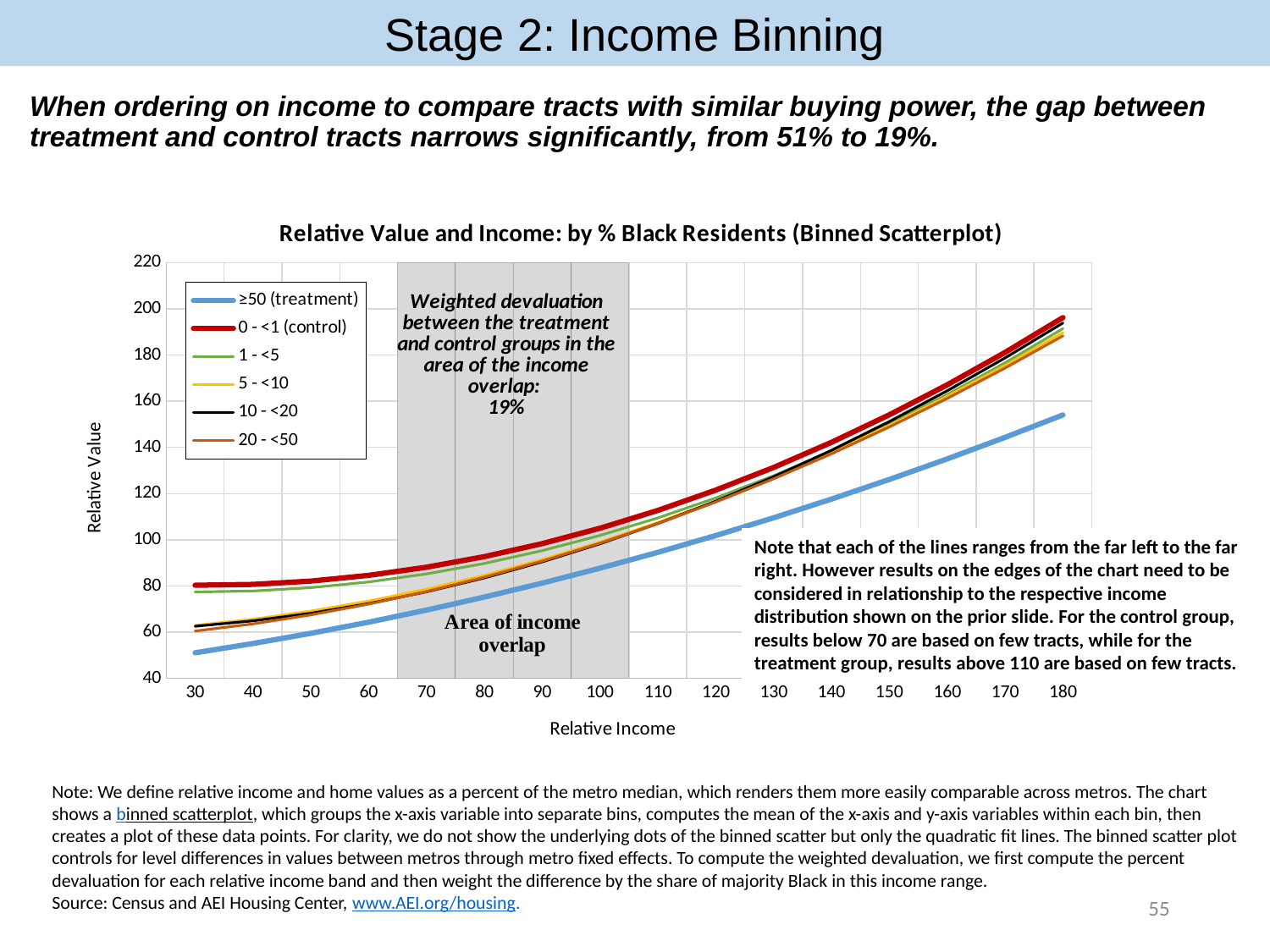
Is the relative value of the ≥50 (treatment) line at a relative income of 150 greater or less than 140? less How many series does the chart's legend list? 6 What weighted devaluation between the treatment and control groups is stated in the area of income overlap? 19% Which series has the lowest relative values across the whole chart? ≥50 (treatment) At a relative income of 100, which is higher: the ≥50 (treatment) line or the 0 - <1 (control) line? 0 - <1 (control) Is the relative value of the 0 - <1 (control) line at a relative income of 180 greater or less than 180? greater What is the title of the chart? Relative Value and Income: by % Black Residents (Binned Scatterplot) Do the values of the ≥50 (treatment) line rise or fall as relative income increases along the x axis? Rise Is the relative value of the 0 - <1 (control) line at a relative income of 30 greater or less than 70? greater What kind of chart is shown on the slide? Line chart